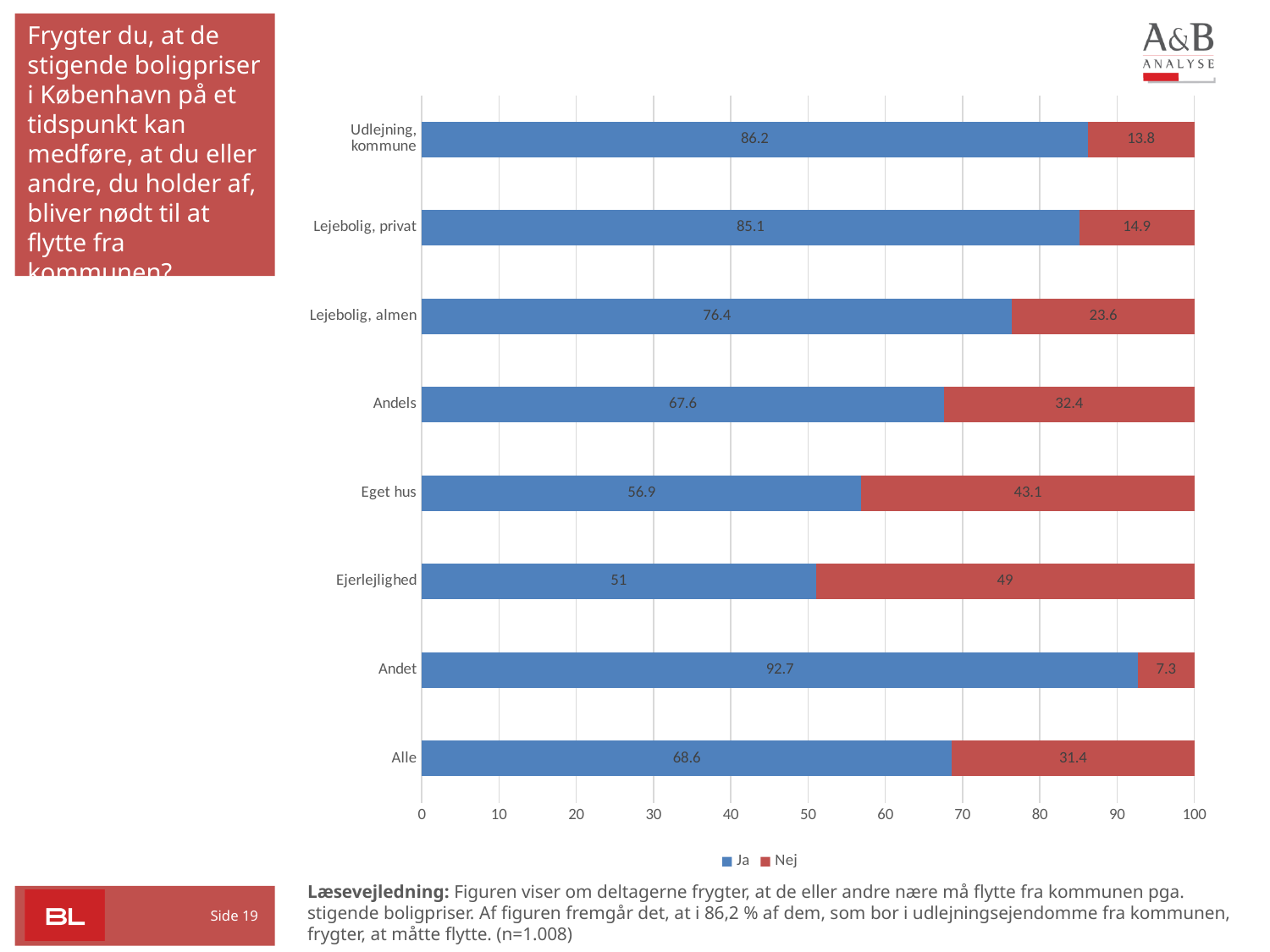
What is the "Nej" value for "Eget hus"? 43.1 What kind of chart is shown on the slide? Stacked bar chart What is the difference between the "Ja" values for "Udlejning, kommune" and "Lejebolig, privat"? 1.1 Which category has the highest "Ja" value? Andet What is the "Ja" value for "Lejebolig, almen"? 76.4 How many categories are shown on the chart? 8 Which category has the lowest "Ja" value? Ejerlejlighed Which colour represents the "Nej" series? Red What is the total of the stacked bar for "Ejerlejlighed"? 100 What is the "Ja" value for "Alle"? 68.6 How many series does the legend list? 2 Which is larger: the "Nej" value for "Andels" or the "Nej" value for "Lejebolig, almen"? Andels